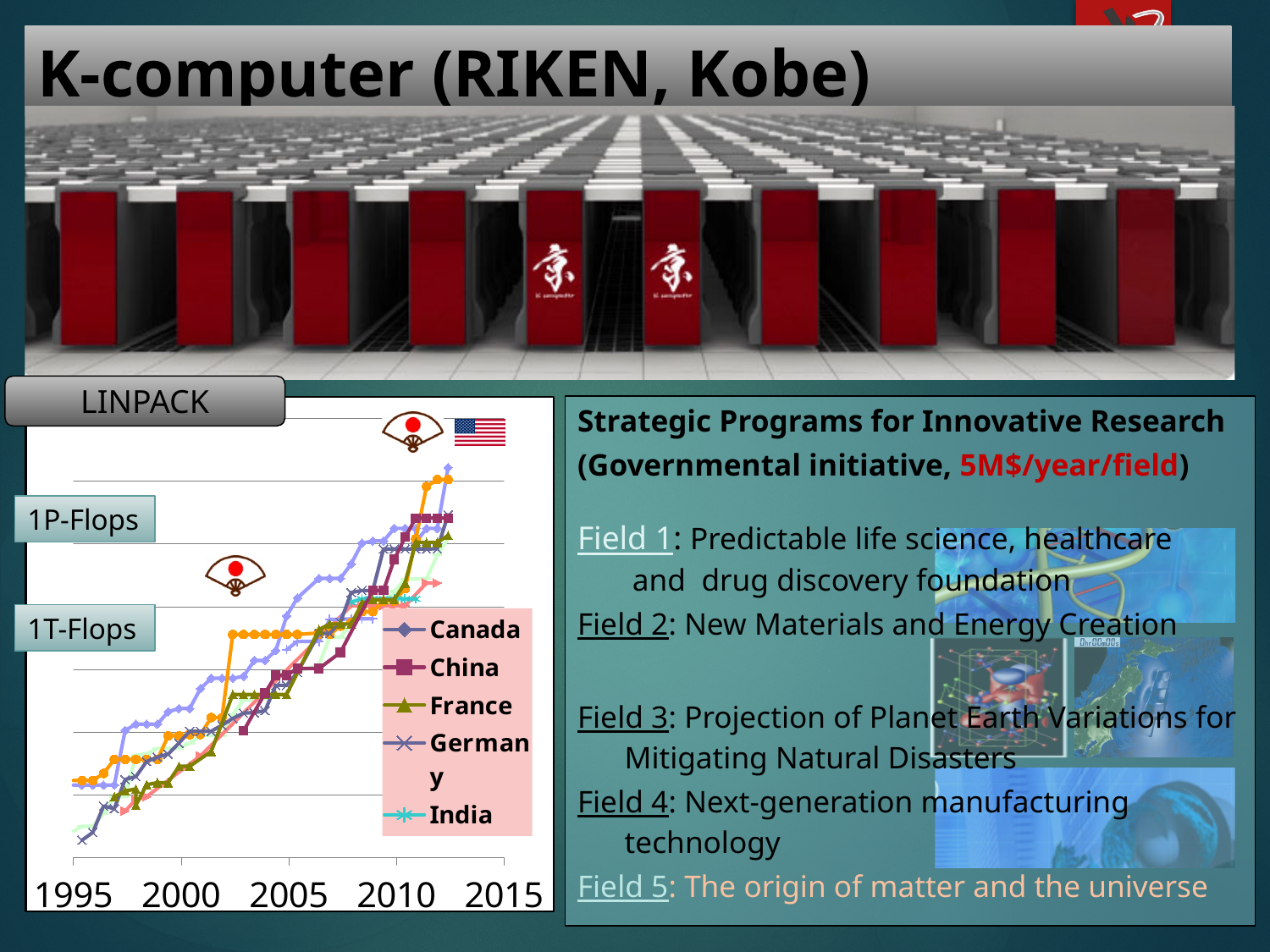
What is the last year labelled on the x axis of the LINPACK chart? 2015 What are the two performance levels labelled on the y axis of the LINPACK chart? 1P-Flops and 1T-Flops Do the plotted values in the LINPACK chart generally rise or fall from 1995 to 2015? rise What kind of chart is shown under the LINPACK label? line chart How many year labels are shown on the x axis of the LINPACK chart? 5 What is the title shown above the line chart? LINPACK Which country is listed first in the legend of the LINPACK chart? Canada What is the first year labelled on the x axis of the LINPACK chart? 1995